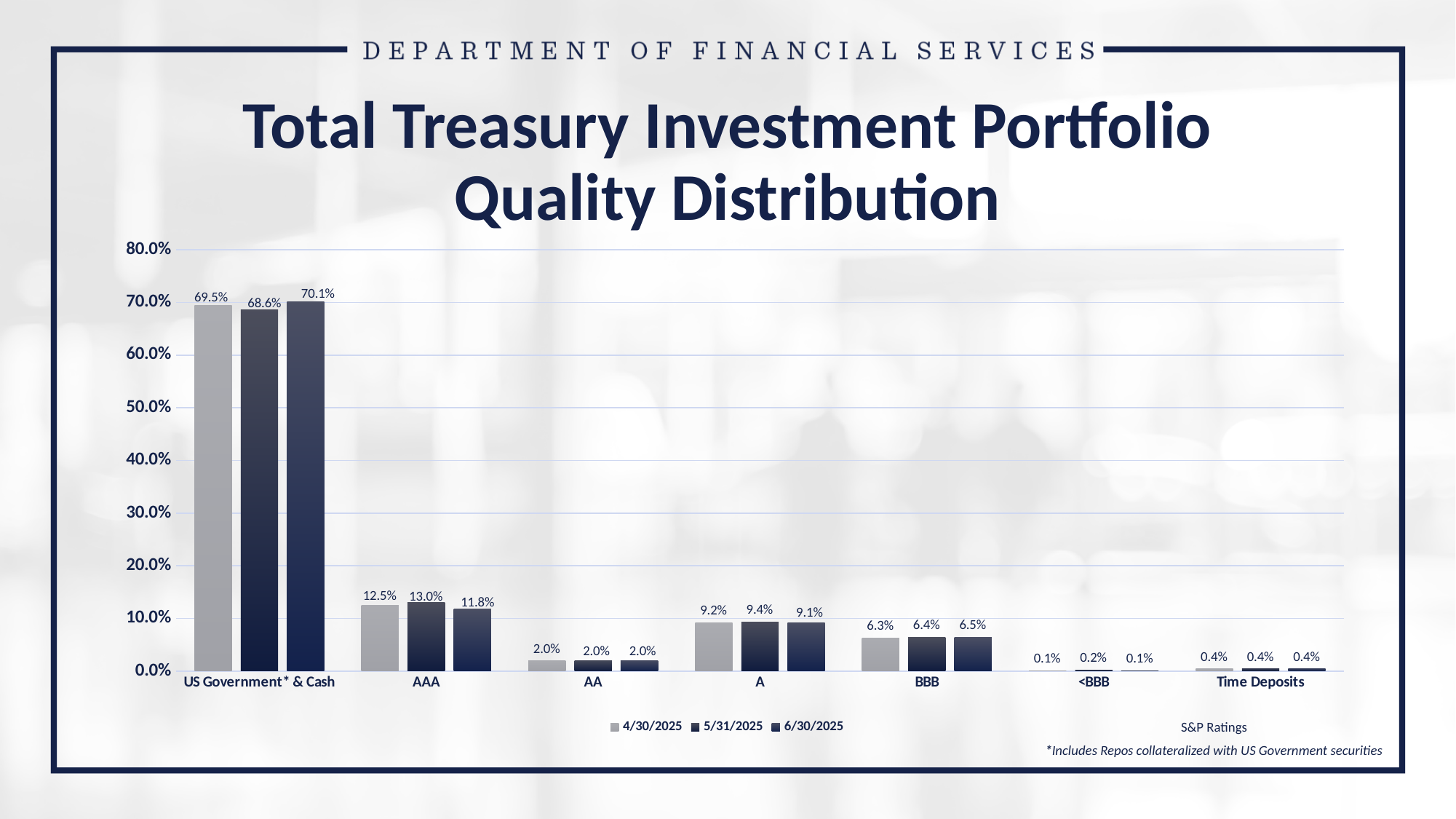
What is the difference between the 6/30/2025 and 5/31/2025 values for US Government* & Cash? 1.5% What kind of chart is shown on the slide? Bar chart How many series does the legend list? 3 What is the value for BBB in the 5/31/2025 series? 6.4% Which category has the highest value in the 6/30/2025 series? US Government* & Cash What is the value for US Government* & Cash in the 6/30/2025 series? 70.1% Which is larger for AAA: the 5/31/2025 value or the 6/30/2025 value? 5/31/2025 What is the value for <BBB in the 5/31/2025 series? 0.2% What is the title of the chart? Total Treasury Investment Portfolio Quality Distribution Which category has the lowest value in the 4/30/2025 series? <BBB What is the value for AAA in the 4/30/2025 series? 12.5% How many categories are shown on the x axis? 7